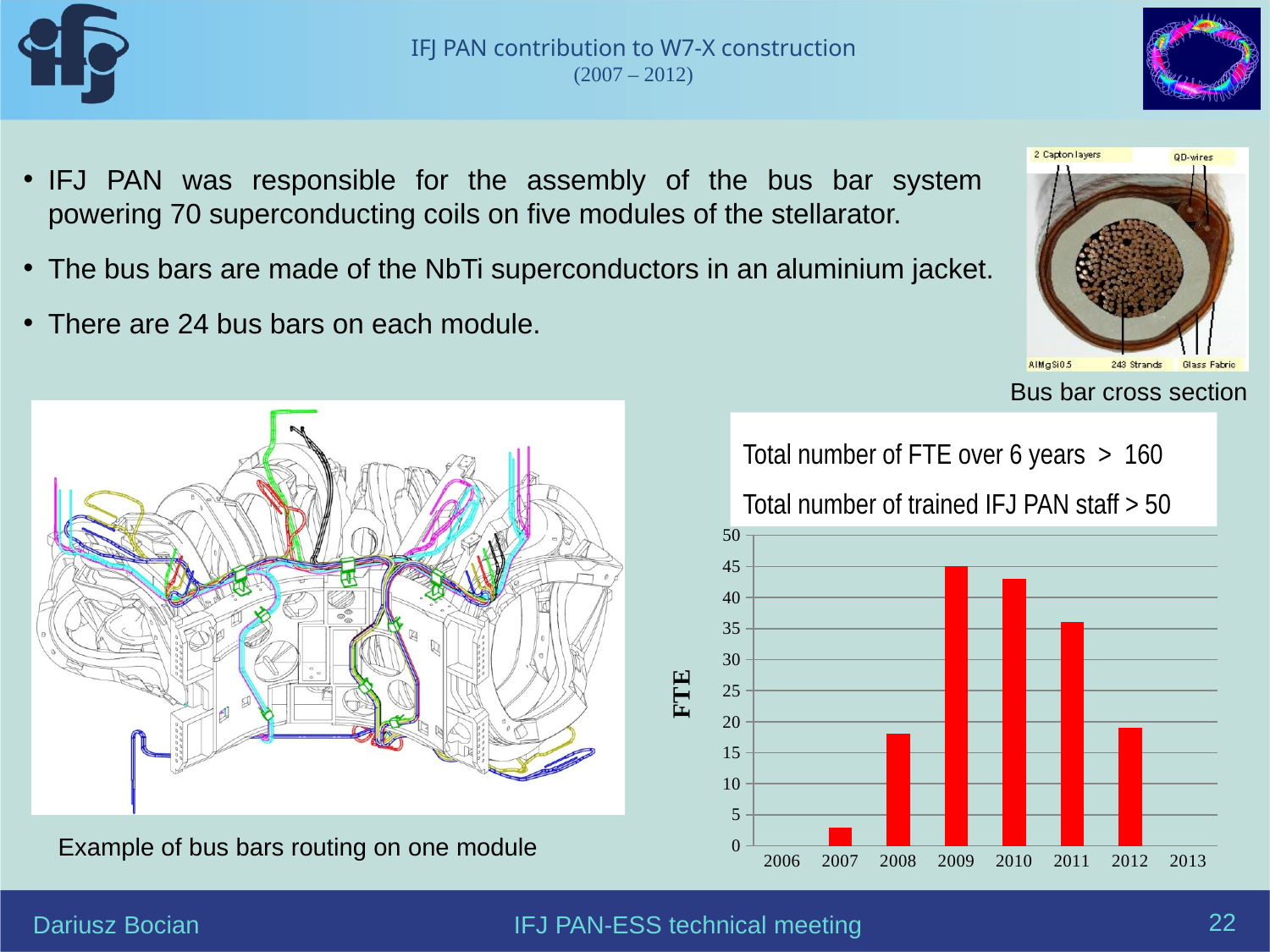
What kind of chart is shown at the bottom right of the slide? bar chart In the FTE chart, is the value for 2009 greater or less than 40? greater In the FTE chart, which year with a visible bar has the lowest value? 2007 In the FTE chart, is the value for 2007 greater or less than 5? less In the FTE chart, which year has the larger value, 2010 or 2011? 2010 In the FTE chart, is the value for 2008 greater or less than 20? less In the FTE chart, do the values rise or fall from 2009 to 2012? fall In the FTE chart, which year has the highest bar? 2009 What is the label on the vertical axis of the chart? FTE How many year labels are shown on the x axis of the FTE chart? 8